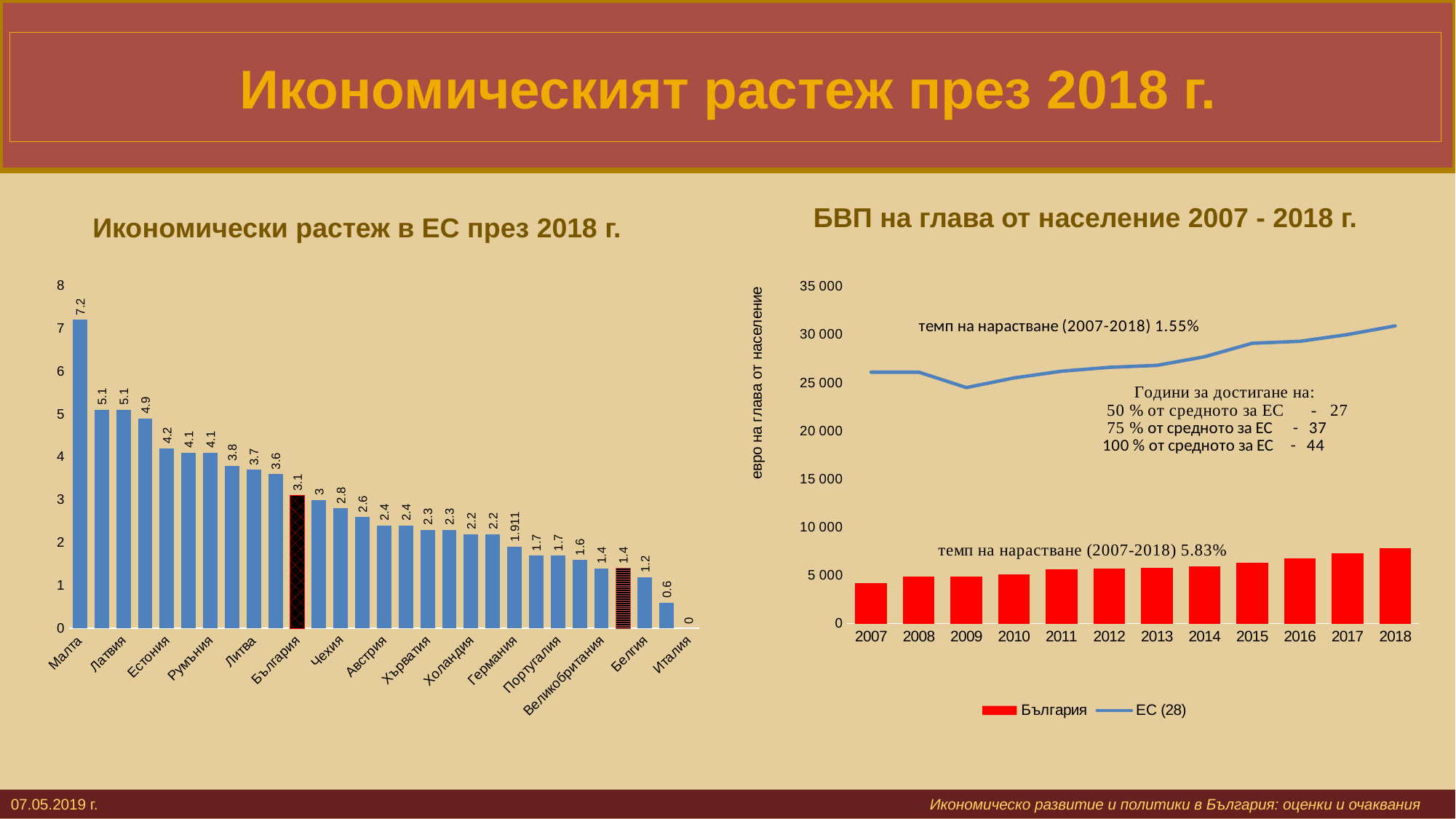
In the chart 'БВП на глава от население 2007 - 2018 г.', is the value for България in 2018 greater or less than 10 000? less In the chart 'Икономически растеж в ЕС през 2018 г.', what is the value for Малта? 7.2 In the chart 'Икономически растеж в ЕС през 2018 г.', what is the difference between the values for Малта and България? 4.1 In the chart 'БВП на глава от население 2007 - 2018 г.', how many series does the legend list? 2 In the chart 'БВП на глава от население 2007 - 2018 г.', do the values for България rise or fall from 2007 to 2018? rise In the chart 'БВП на глава от население 2007 - 2018 г.', is the value for ЕС (28) in 2018 greater or less than 30 000? greater In the chart 'Икономически растеж в ЕС през 2018 г.', what is the value for България? 3.1 In the chart 'Икономически растеж в ЕС през 2018 г.', which country has the highest value? Малта In the chart 'Икономически растеж в ЕС през 2018 г.', which is larger, the value for Естония or the value for Чехия? Естония In the chart 'Икономически растеж в ЕС през 2018 г.', what is the value for Италия? 0 In the chart 'Икономически растеж в ЕС през 2018 г.', what is the value for Латвия? 5.1 In the chart 'БВП на глава от население 2007 - 2018 г.', how many years are shown on the x axis? 12